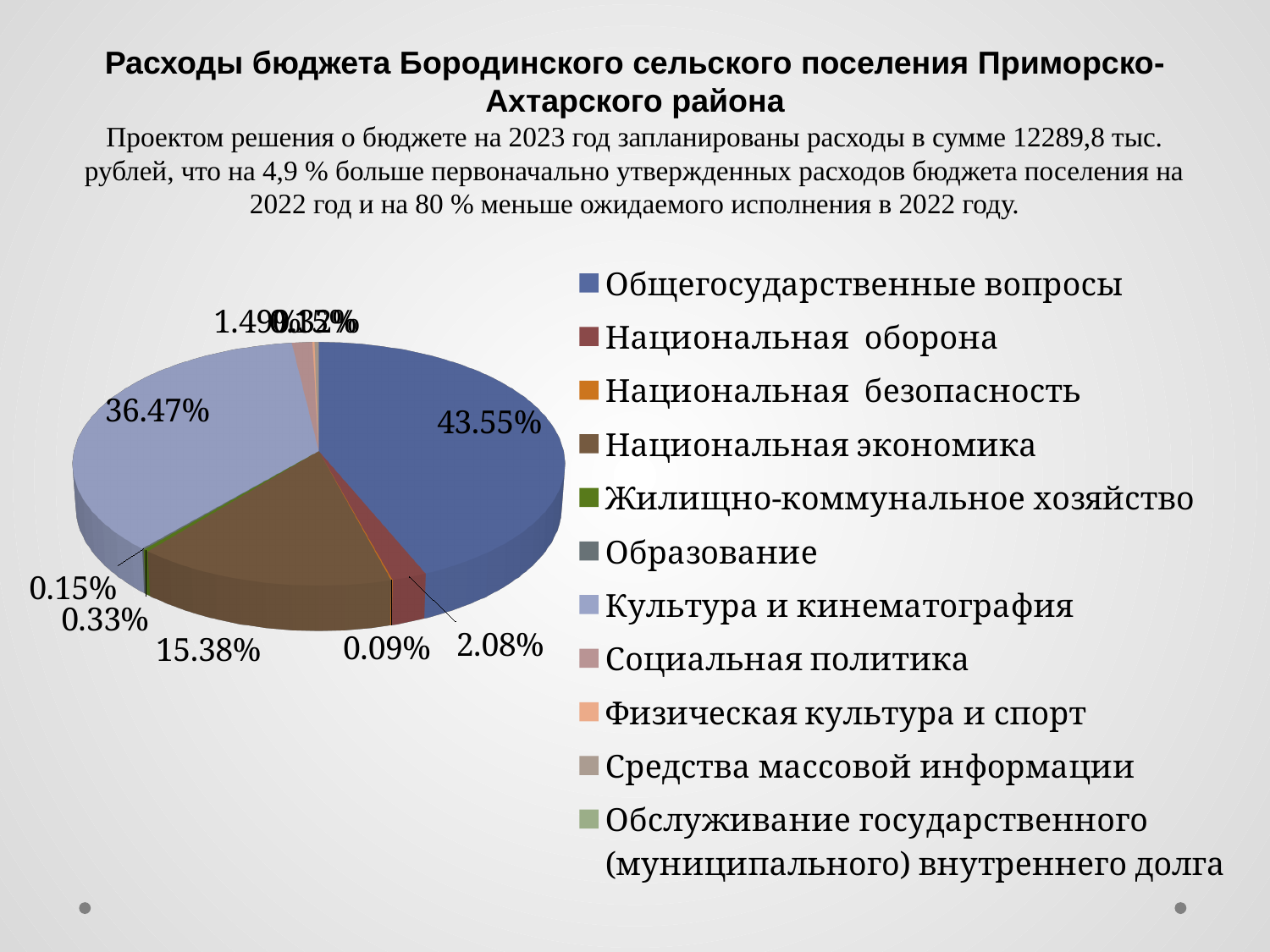
What share of the budget expenditures goes to Культура и кинематография? 36.47% Which category has the largest share of the budget expenditures? Общегосударственные вопросы What is the difference in percentage points between the shares for Общегосударственные вопросы and Культура и кинематография? 7.08 What share of the budget expenditures goes to Национальная оборона? 2.08% What share of the budget expenditures goes to Национальная безопасность? 0.09% What colour is the slice for Общегосударственные вопросы? blue What kind of chart is shown on the slide? pie chart What share of the budget expenditures goes to Социальная политика? 1.49% How many categories does the legend of the pie chart list? 11 What share of the budget expenditures goes to Национальная экономика? 15.38% Which is larger: the share for Культура и кинематография or the share for Национальная экономика? Культура и кинематография What share of the budget expenditures goes to Общегосударственные вопросы? 43.55%